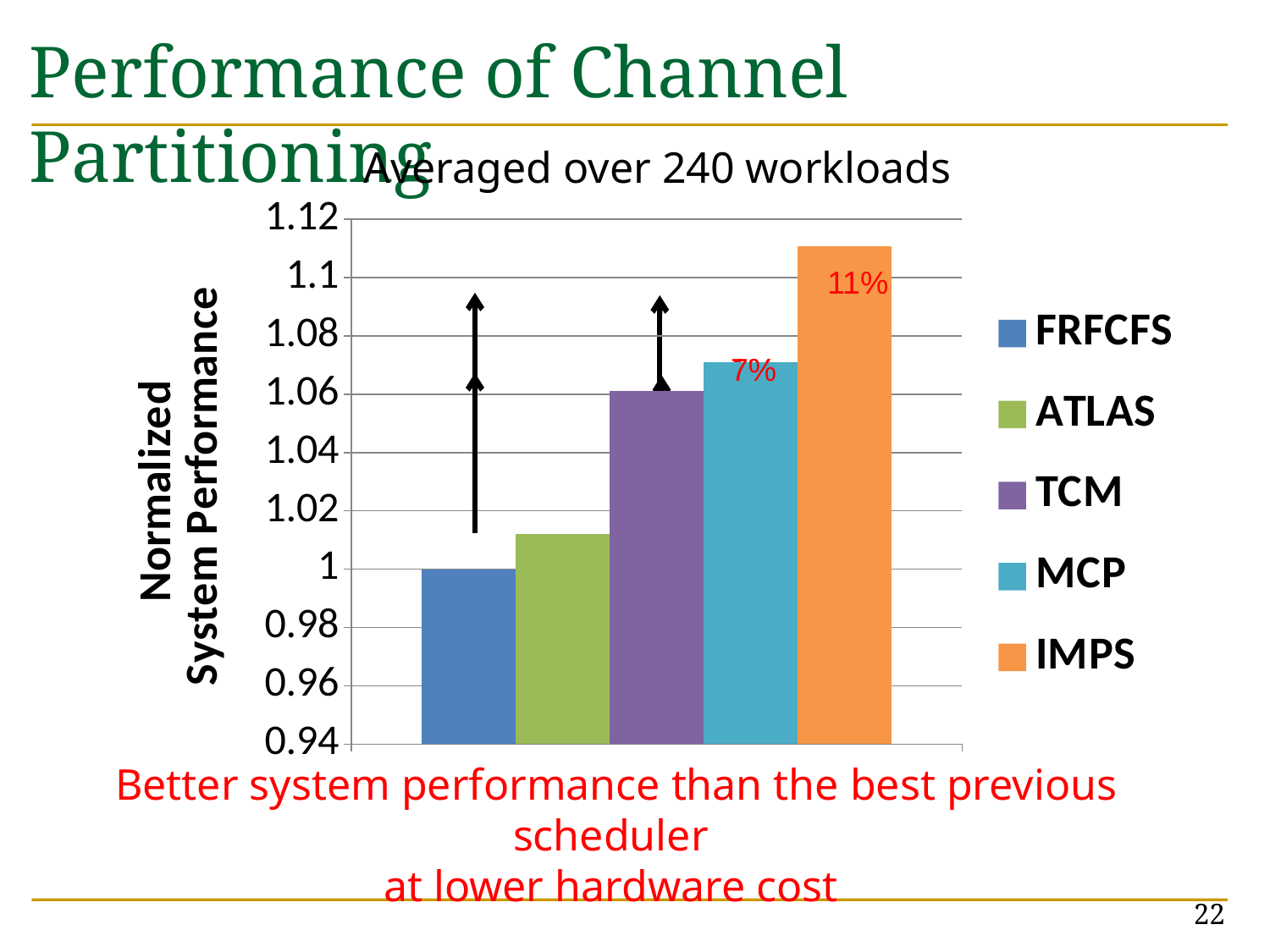
What is the normalized system performance value for FRFCFS? 1 How many series does the chart's legend list? 5 What is the label on the vertical axis of the chart? Normalized System Performance Which series has the lowest normalized system performance? FRFCFS Is the value for IMPS greater or less than 1.08? greater Do the bar values rise or fall from left to right across the chart? rise Is the value for TCM greater or less than 1.04? greater What kind of chart is shown on the slide? bar chart Which is larger, the value for ATLAS or the value for TCM? TCM Is the value for ATLAS greater or less than 1.02? less What is the title of the chart? Averaged over 240 workloads Which series has the highest normalized system performance? IMPS